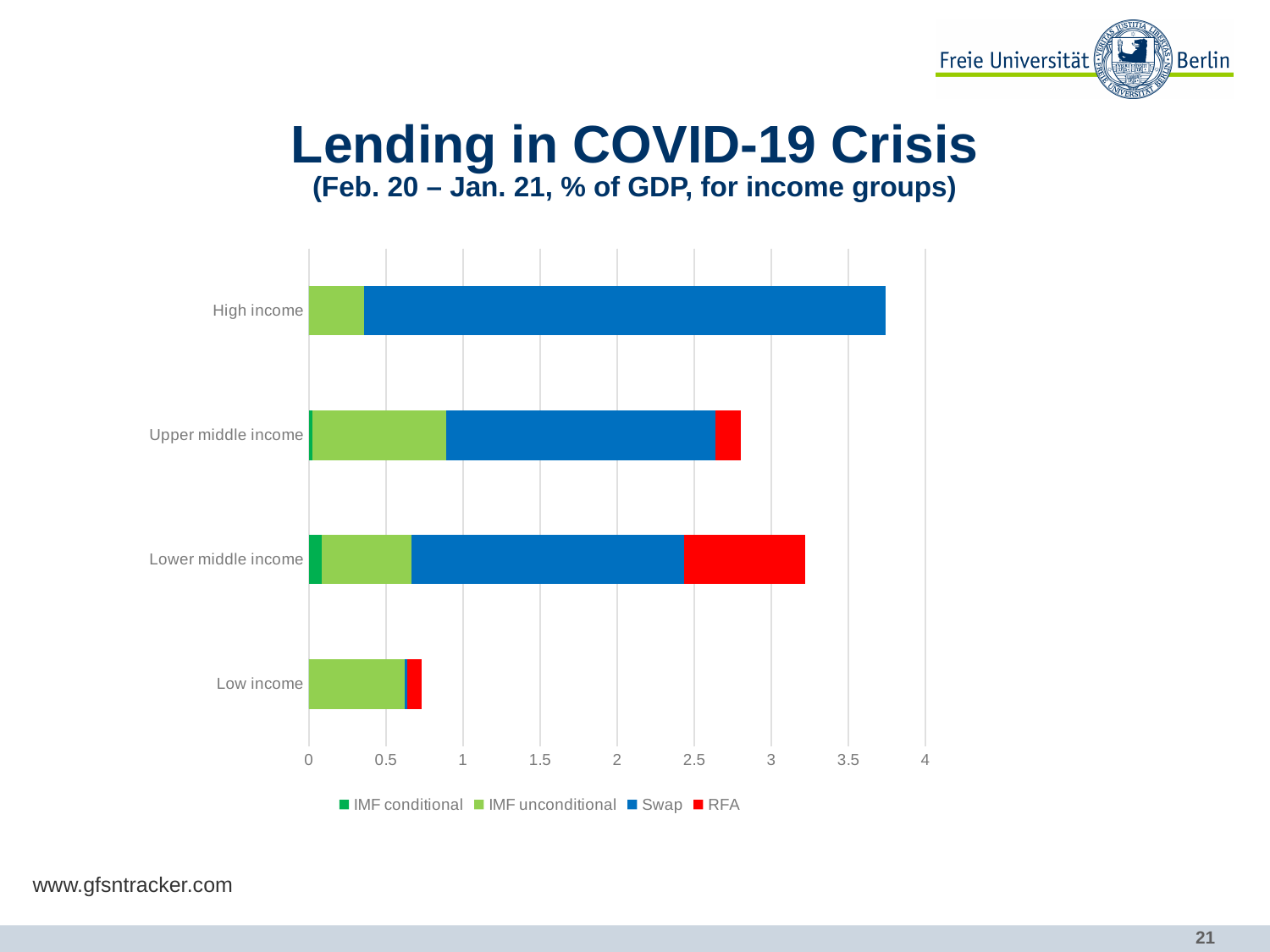
Which income group has the smallest total bar? Low income Is the total value for High income greater or less than 3.5? greater Which series is shown in blue in the legend? Swap How many series does the legend list? 4 Is the total value for Upper middle income greater or less than 2.5? greater Is the total value for Low income greater or less than 1? less What kind of chart is shown on the slide? Bar chart Which has the larger total bar, Upper middle income or Lower middle income? Lower middle income What is the title of the chart? Lending in COVID-19 Crisis How many income groups are shown on the chart? 4 Which income group has the largest total bar? High income